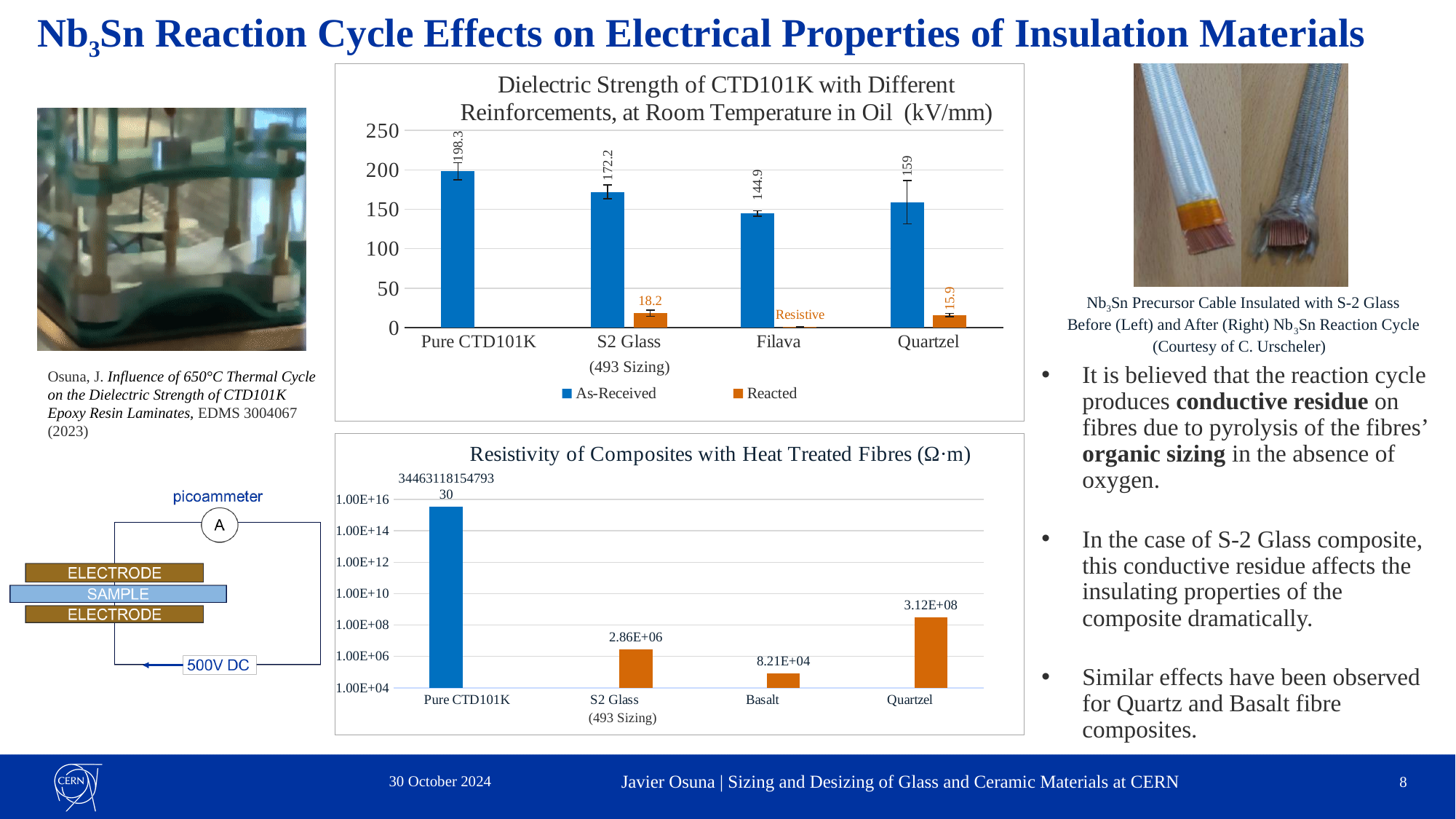
In the Dielectric Strength chart, how many series does the legend list? 2 In the Resistivity of Composites chart, what is the value for S2 Glass (493 Sizing)? 2.86E+06 In the Resistivity of Composites chart, which category has the lowest value? Basalt In the Dielectric Strength chart, what is the Reacted value for Quartzel? 15.9 In the Dielectric Strength chart, which category has the highest As-Received value? Pure CTD101K In the Dielectric Strength chart, what is the difference between the As-Received values for Pure CTD101K and S2 Glass (493 Sizing)? 26.1 In the Dielectric Strength chart, what is the As-Received value for Pure CTD101K? 198.3 In the Resistivity of Composites chart, what is the value for Basalt? 8.21E+04 In the Dielectric Strength chart, which category has the lowest As-Received value? Filava In the Dielectric Strength chart, what is the Reacted value for S2 Glass (493 Sizing)? 18.2 What type of chart is the Resistivity of Composites chart? Bar chart In the Dielectric Strength chart, what label is shown for the Reacted Filava sample? Resistive